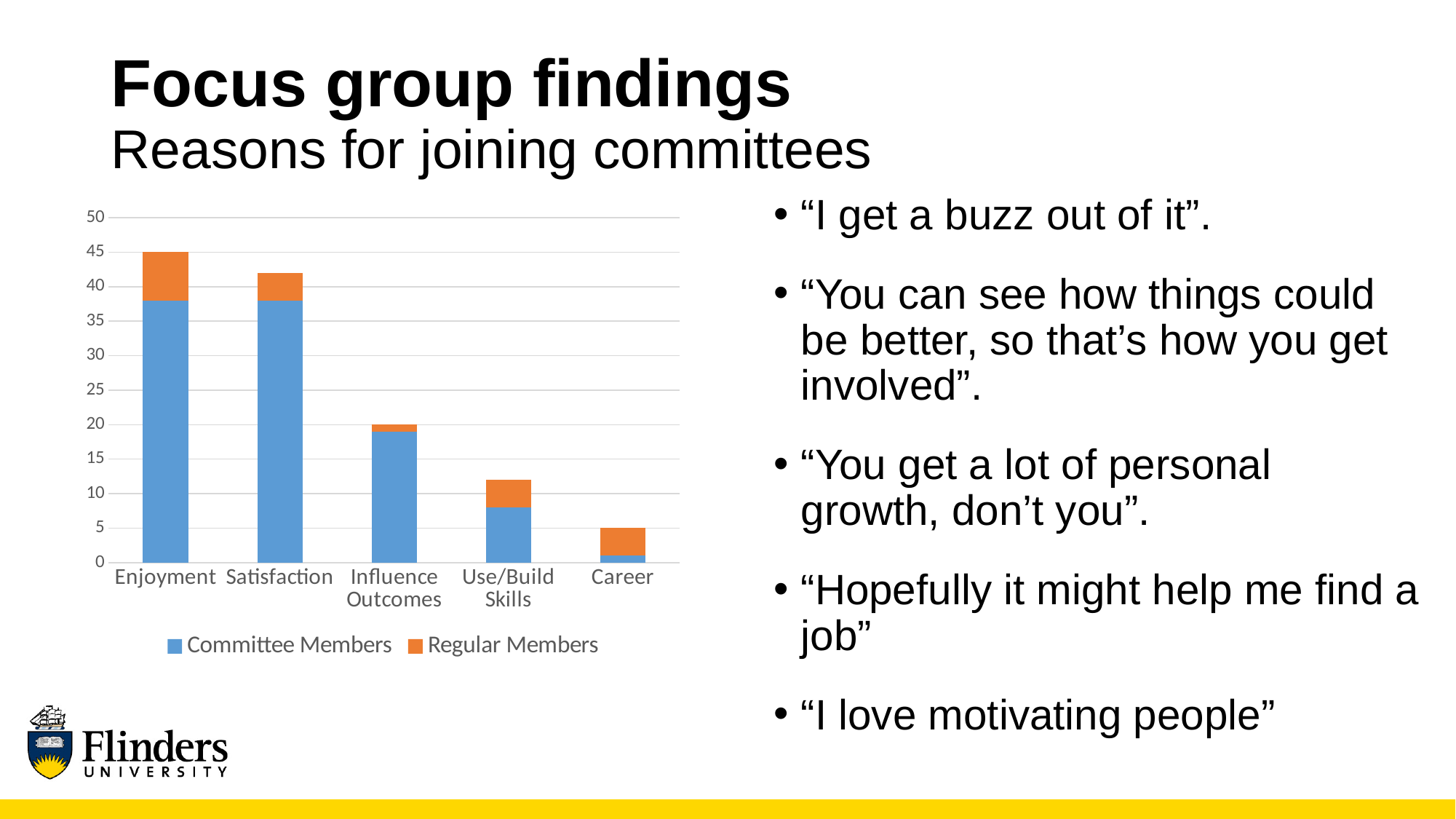
How many series does the chart legend list? 2 Which has a larger total bar, Influence Outcomes or Use/Build Skills? Influence Outcomes What is the total height of the stacked bar for Enjoyment? 45 Is the total value for Satisfaction greater or less than 40? greater What kind of chart is shown on the slide? stacked bar chart What is the total height of the stacked bar for Influence Outcomes? 20 Which series is shown in orange in the chart? Regular Members Is the Committee Members value for Use/Build Skills greater or less than 10? less Which category has the tallest stacked bar in the chart? Enjoyment How many categories are shown on the x axis of the chart? 5 What is the total height of the stacked bar for Career? 5 Which category has the shortest stacked bar in the chart? Career